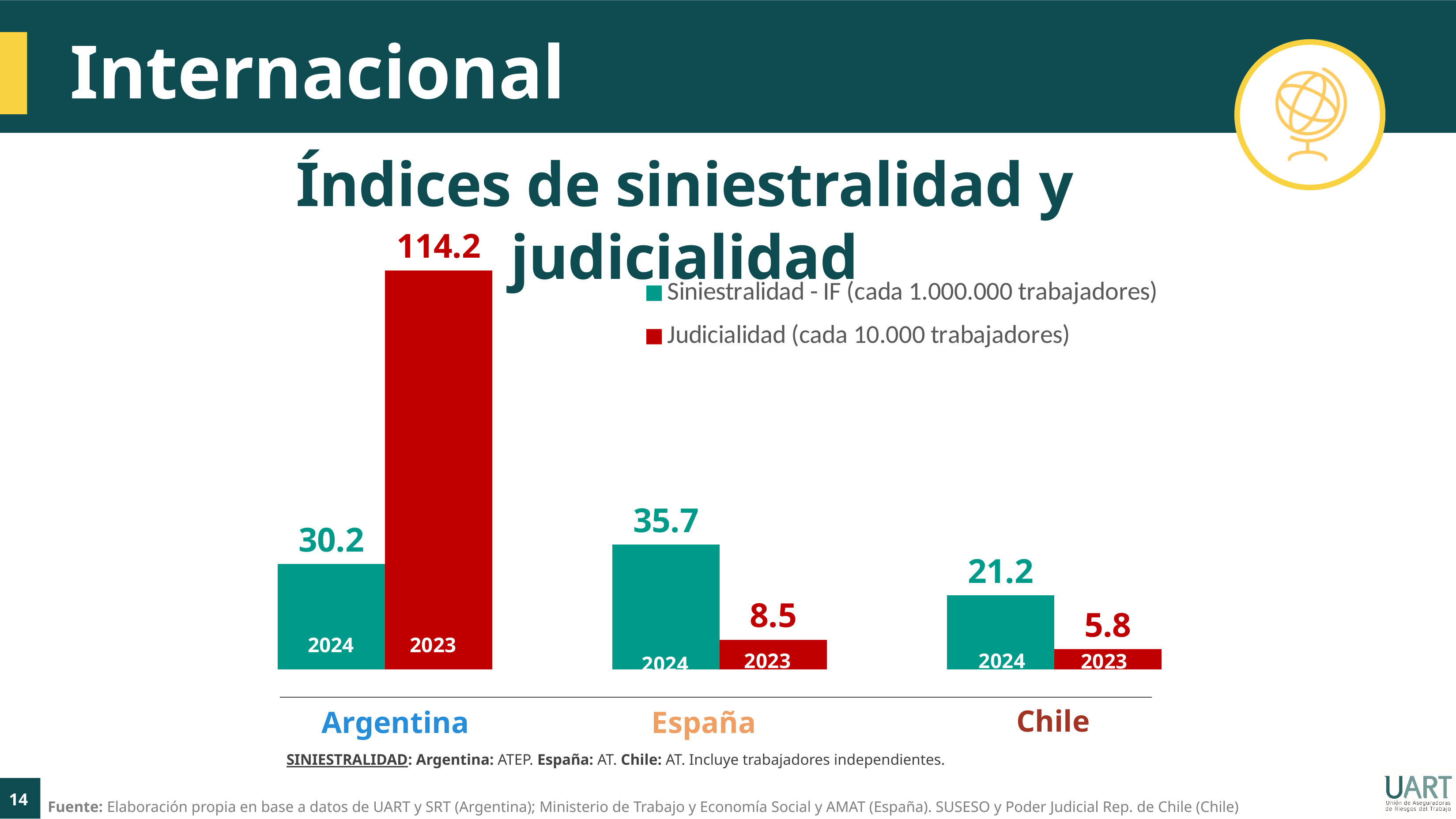
How many countries are shown on the x axis of the chart? 3 What is the Judicialidad value for Chile? 5.8 Which country has the highest Siniestralidad - IF value? España What is the difference between the Judicialidad values for Argentina and España? 105.7 Which country has the lowest Judicialidad value? Chile What is the Siniestralidad - IF value for España? 35.7 Which is larger, the Siniestralidad - IF value for Chile or the Judicialidad value for Chile? Siniestralidad - IF value for Chile How many series does the legend list? 2 What is the Judicialidad value for Argentina? 114.2 Which colour represents the Judicialidad series in the chart? Red What kind of chart is shown on the slide? Bar chart What is the Siniestralidad - IF value for Argentina? 30.2